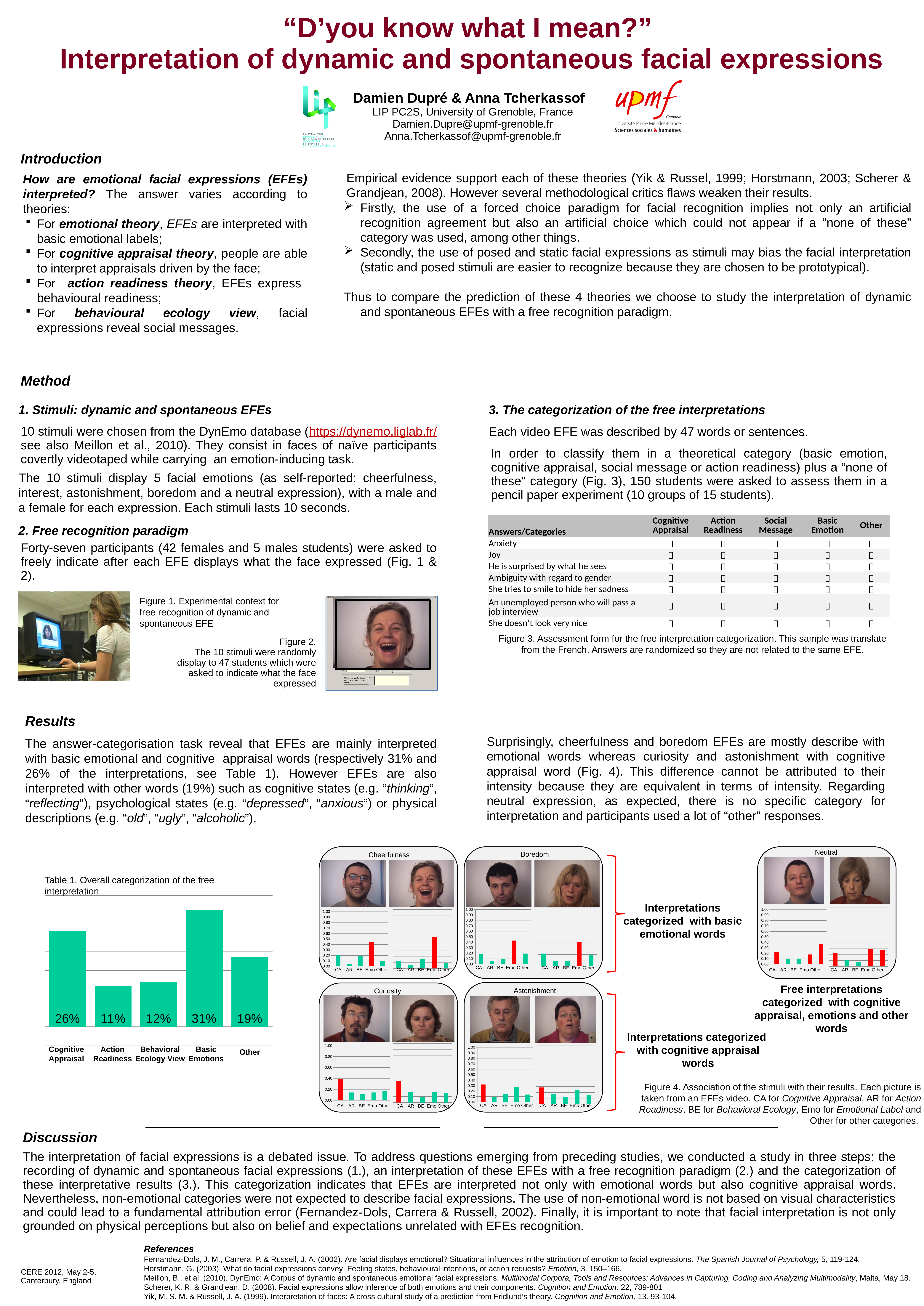
In the Figure 4 chart for Curiosity (left face), which category has the highest bar? CA In the chart titled "Table 1. Overall categorization of the free interpretation", what is the value for Cognitive Appraisal? 26% In the chart titled "Table 1. Overall categorization of the free interpretation", what is the value for Action Readiness? 11% In the chart titled "Table 1. Overall categorization of the free interpretation", which category has the lowest value? Action Readiness In the chart titled "Table 1. Overall categorization of the free interpretation", which is larger, the value for Cognitive Appraisal or the value for Other? Cognitive Appraisal In the chart titled "Table 1. Overall categorization of the free interpretation", what is the difference between the values for Other and Behavioral Ecology View? 7% In the chart titled "Table 1. Overall categorization of the free interpretation", which category has the highest value? Basic Emotions How many categories are shown in the chart titled "Table 1. Overall categorization of the free interpretation"? 5 What kind of chart is the one titled "Table 1. Overall categorization of the free interpretation"? Bar chart In the chart titled "Table 1. Overall categorization of the free interpretation", what is the value for Basic Emotions? 31% In the chart titled "Table 1. Overall categorization of the free interpretation", what is the difference between the values for Basic Emotions and Cognitive Appraisal? 5% In the chart titled "Table 1. Overall categorization of the free interpretation", what is the value for Other? 19%